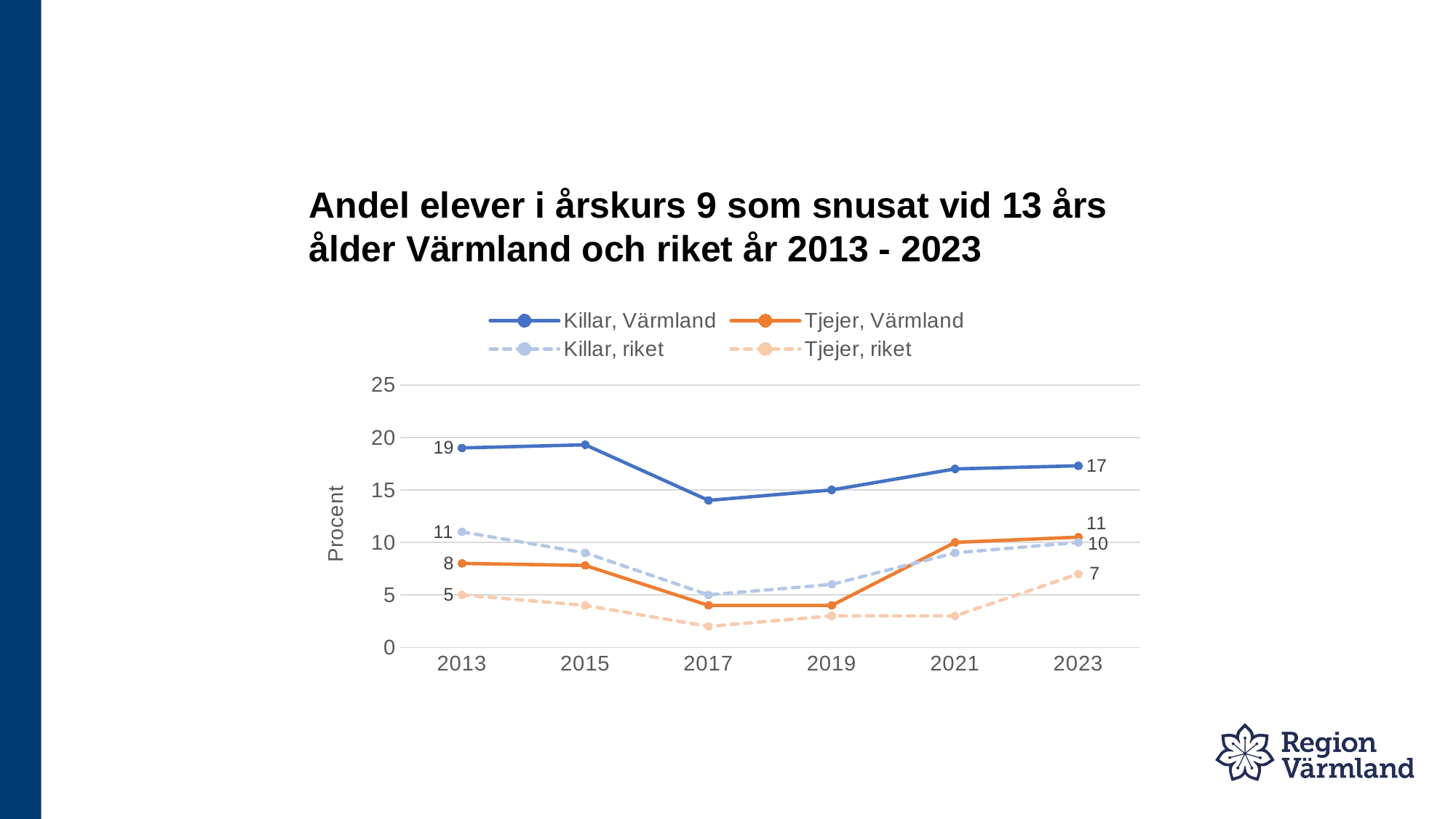
How many years are plotted along the x axis? 6 What kind of chart is shown on the slide? line chart What is the value for Tjejer, riket in 2013? 5 Which series are drawn with dashed lines? Killar, riket and Tjejer, riket Which series has the lowest value in 2013? Tjejer, riket What is the value for Killar, Värmland in 2023? 17 What is the value for Killar, Värmland in 2013? 19 What is the difference between Killar, Värmland and Tjejer, Värmland in 2013? 11 What is the value for Tjejer, Värmland in 2023? 11 Is the value for Killar, Värmland in 2017 greater or less than 15? less How many series does the legend list? 4 Which series has the highest value in 2023? Killar, Värmland